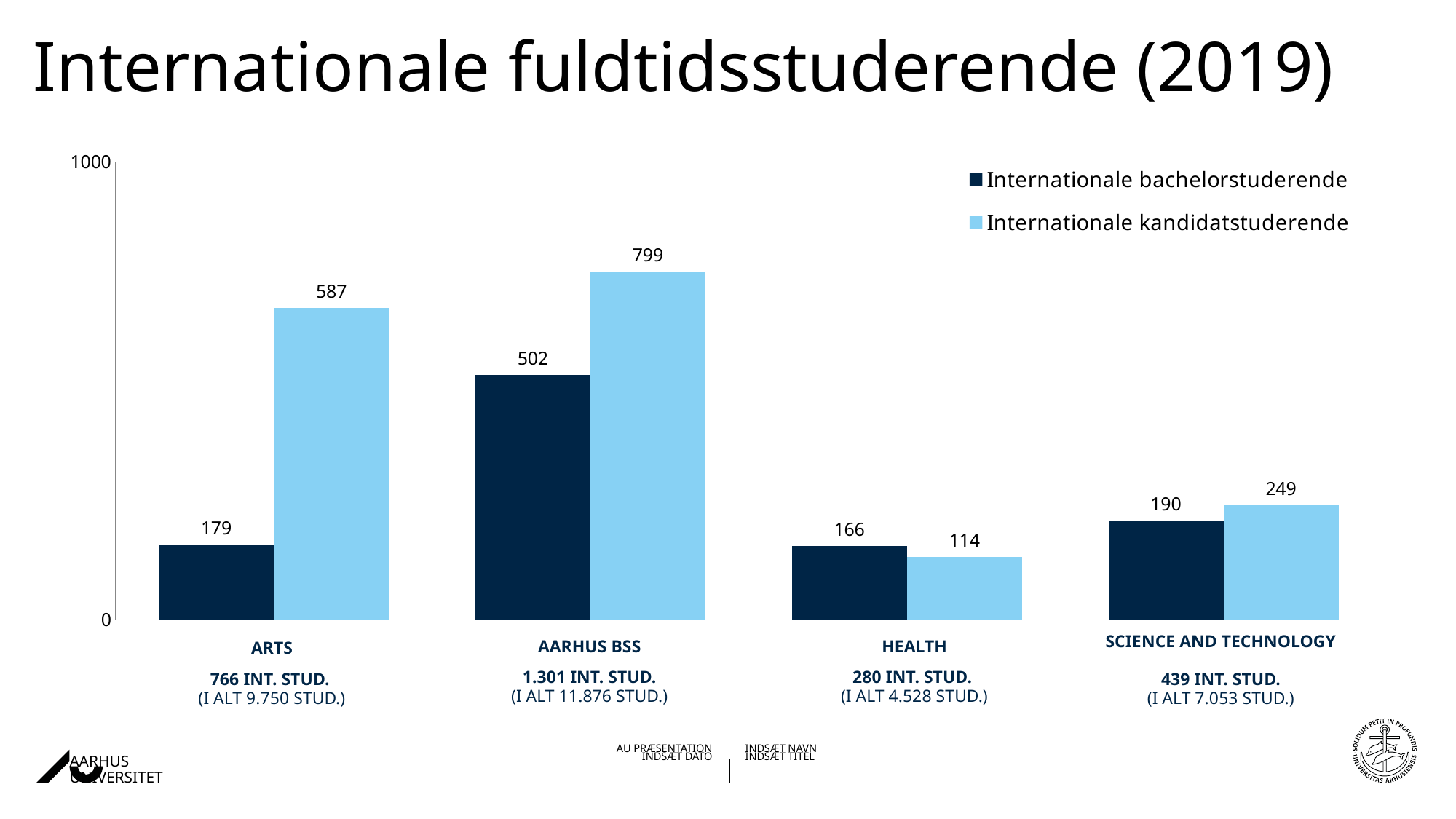
Which category has the lowest value for Internationale bachelorstuderende? Health What is the difference between Internationale kandidatstuderende and Internationale bachelorstuderende at Arts? 408 What colour represents Internationale kandidatstuderende in the legend? light blue How many categories are shown on the x axis? 4 Which category has the highest value for Internationale kandidatstuderende? Aarhus BSS What is the value for Internationale bachelorstuderende at Arts? 179 Is the value for Internationale bachelorstuderende at Aarhus BSS greater or less than 1000? less What kind of chart is shown on the slide? bar chart How many series does the legend list? 2 What is the value for Internationale kandidatstuderende at Health? 114 At Health, which is larger: Internationale bachelorstuderende or Internationale kandidatstuderende? Internationale bachelorstuderende What is the value for Internationale kandidatstuderende at Aarhus BSS? 799